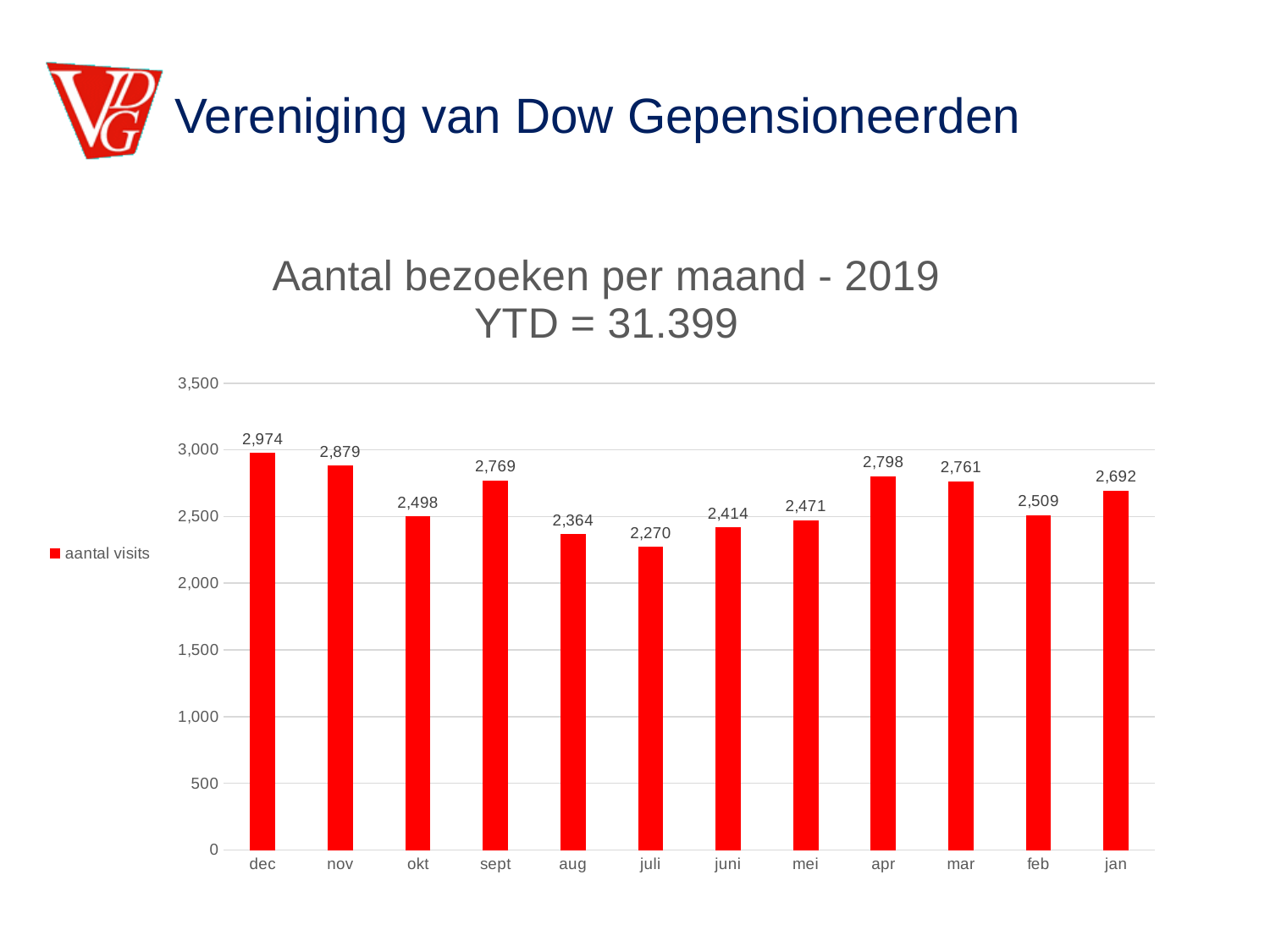
Which month has the highest value? dec How many series does the legend list? 1 How many months are shown on the x axis? 12 What is the value for juli? 2,270 What is the value for dec? 2,974 Which is larger, the value for okt or the value for feb? feb Which month has the lowest value? juli What is the legend entry for the series? aantal visits Is the value for aug greater or less than 2,500? less What kind of chart is shown? bar chart What is the difference between the values for dec and nov? 95 What is the value for apr? 2,798